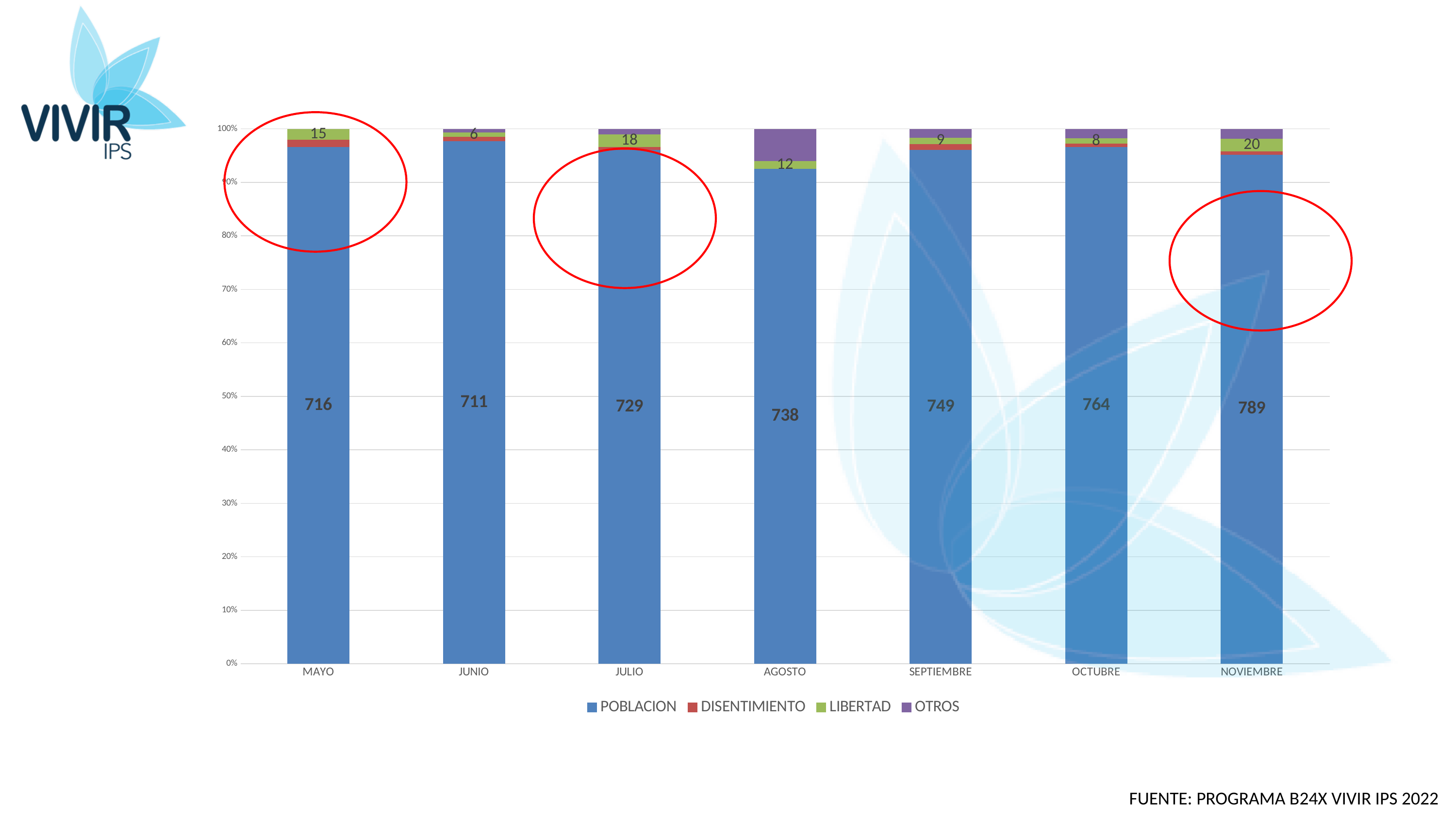
Which series is shown in purple in the legend? OTROS What is the POBLACION value for JUNIO? 711 Which is larger, the LIBERTAD value for MAYO or for SEPTIEMBRE? MAYO What is the LIBERTAD value for JULIO? 18 What is the LIBERTAD value for AGOSTO? 12 Which month has the highest POBLACION value? NOVIEMBRE How many months are shown on the x axis? 7 What kind of chart is shown on the slide? Stacked bar chart What is the POBLACION value for NOVIEMBRE? 789 What is the difference between the POBLACION values for NOVIEMBRE and MAYO? 73 How many series does the legend list? 4 Which month has the lowest LIBERTAD value? JUNIO